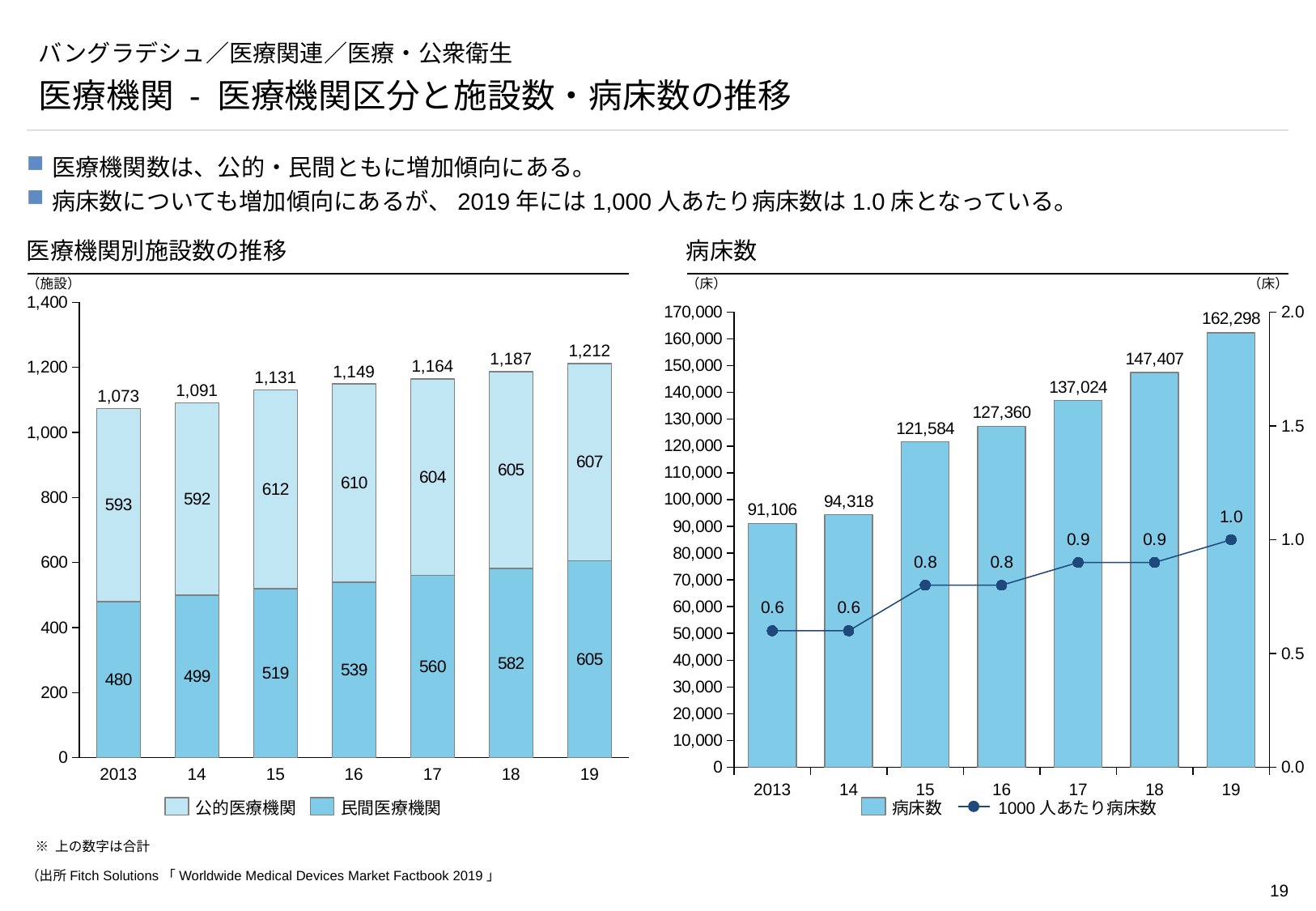
In the 病床数 chart, what is the value of 1000 人あたり病床数 in 2015? 0.8 In the 病床数 chart, how many years are plotted on the x axis? 7 In the 医療機関別施設数の推移 chart, does the total number of facilities rise or fall from 2013 to 2019? rise In the 医療機関別施設数の推移 chart, what is the total number of facilities in 2019? 1,212 In the 医療機関別施設数の推移 chart, what is the value for 民間医療機関 in 2013? 480 In the 病床数 chart, what is the number of beds (病床数) in 2019? 162,298 In the 医療機関別施設数の推移 chart, how many series does the legend list? 2 In the 病床数 chart, which year has the lowest number of beds? 2013 In the 病床数 chart, what is the difference in 病床数 between 2018 and 2017? 10,383 In the 医療機関別施設数の推移 chart, what is the value for 公的医療機関 in 2015? 612 What kind of chart is the 病床数 chart? Bar chart with a line In the 医療機関別施設数の推移 chart, how much did the number of 民間医療機関 increase from 2013 to 2019? 125